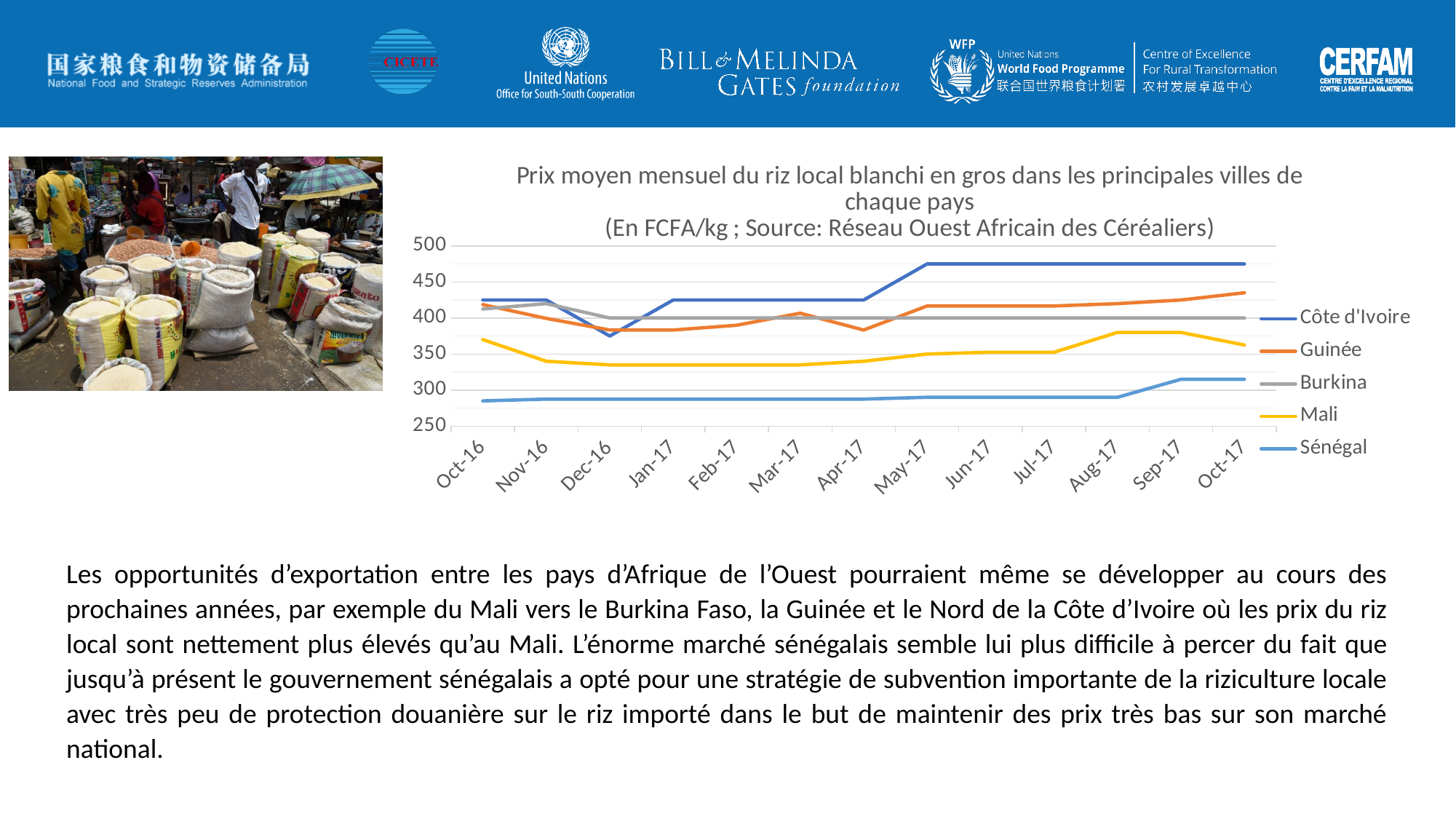
How many months are shown along the x axis? 13 Which country has the highest price in Oct-17? Côte d'Ivoire Is the value for Sénégal in Oct-16 greater or less than 300? less How many series does the legend list? 5 Does the price for Sénégal rise or fall between Aug-17 and Sep-17? rise What kind of chart is shown on the slide? line chart Which is larger in Oct-17, the value for Guinée or the value for Mali? Guinée Is the value for Guinée in Oct-17 greater or less than 400? greater Is the value for Mali in Dec-16 greater or less than 350? less Which country has the lowest price in Oct-16? Sénégal What unit is given in the chart title for the prices? FCFA/kg